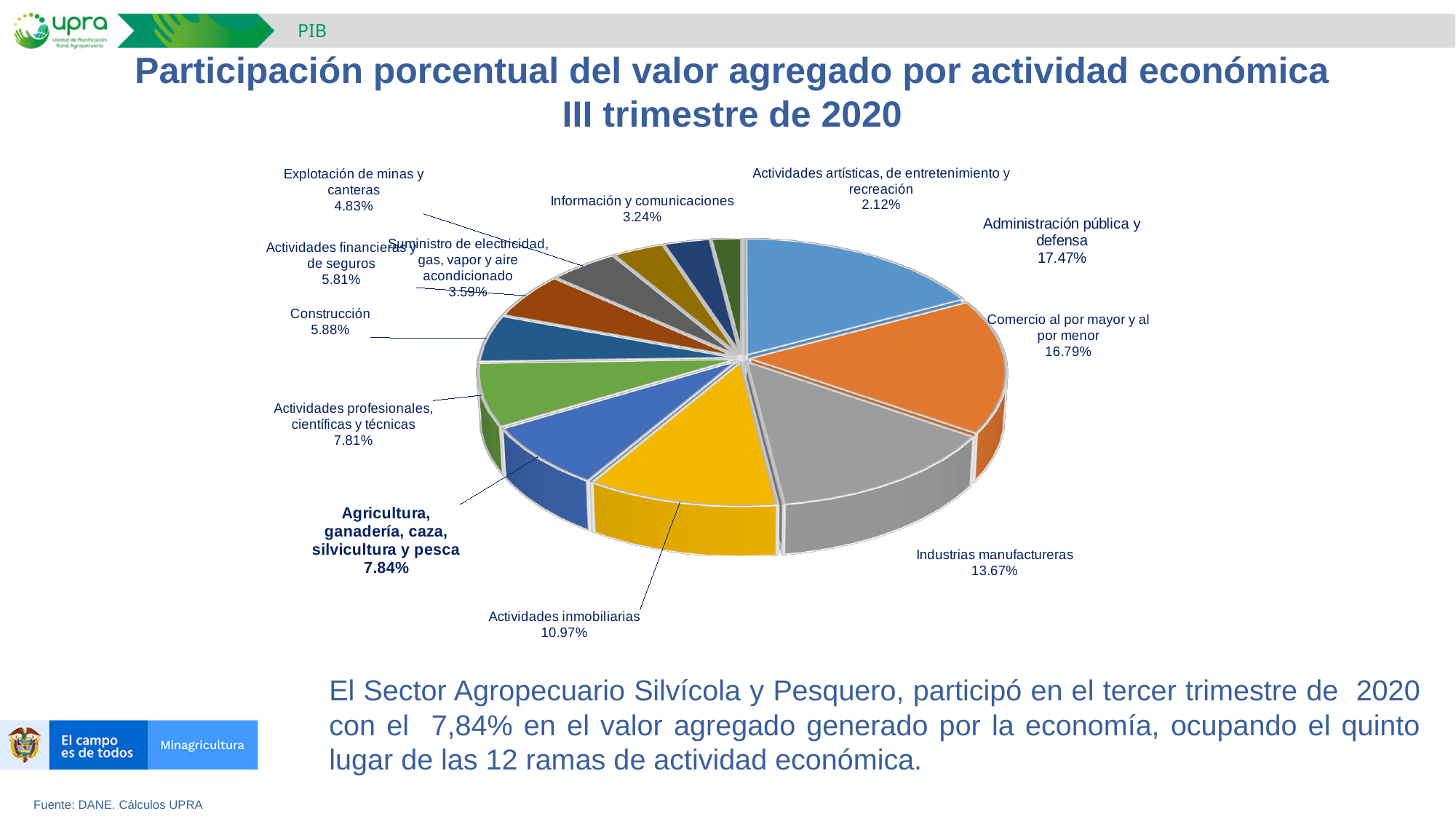
What is the share of Agricultura, ganadería, caza, silvicultura y pesca? 7.84% What is the title of the chart? Participación porcentual del valor agregado por actividad económica III trimestre de 2020 What kind of chart is shown on the slide? Pie chart What is the share of Actividades inmobiliarias? 10.97% Which activity has the largest share in the pie chart? Administración pública y defensa What is the share of Industrias manufactureras? 13.67% Which activity has the smallest share in the pie chart? Actividades artísticas, de entretenimiento y recreación How many activity categories are shown in the pie chart? 12 What is the share of Administración pública y defensa? 17.47% What is the difference between the shares of Administración pública y defensa and Comercio al por mayor y al por menor? 0.68% What is the difference between the shares of Industrias manufactureras and Actividades inmobiliarias? 2.70% Which has a larger share, Construcción or Explotación de minas y canteras? Construcción